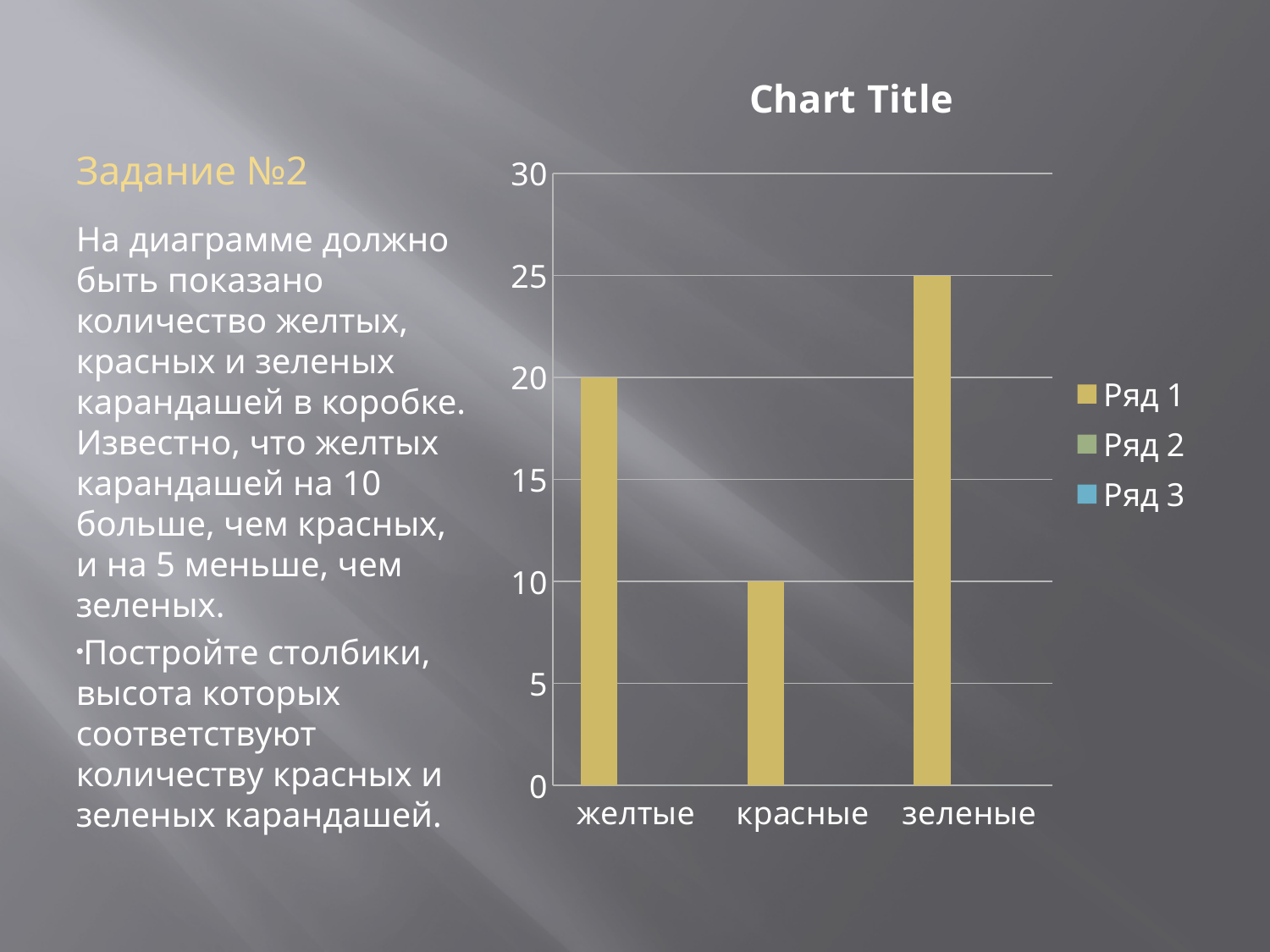
What kind of chart is shown on the slide? bar chart Which category has the lowest value? красные Is the value for зеленые greater or less than 15? greater What is the value for желтые? 20 What is the difference between the values for зеленые and желтые? 5 How many series does the legend list? 3 Which category has the highest value? зеленые What is the difference between the values for желтые and красные? 10 What is the value for красные? 10 Which is larger, the value for желтые or the value for красные? желтые How many categories are shown on the x axis? 3 What is the value for зеленые? 25